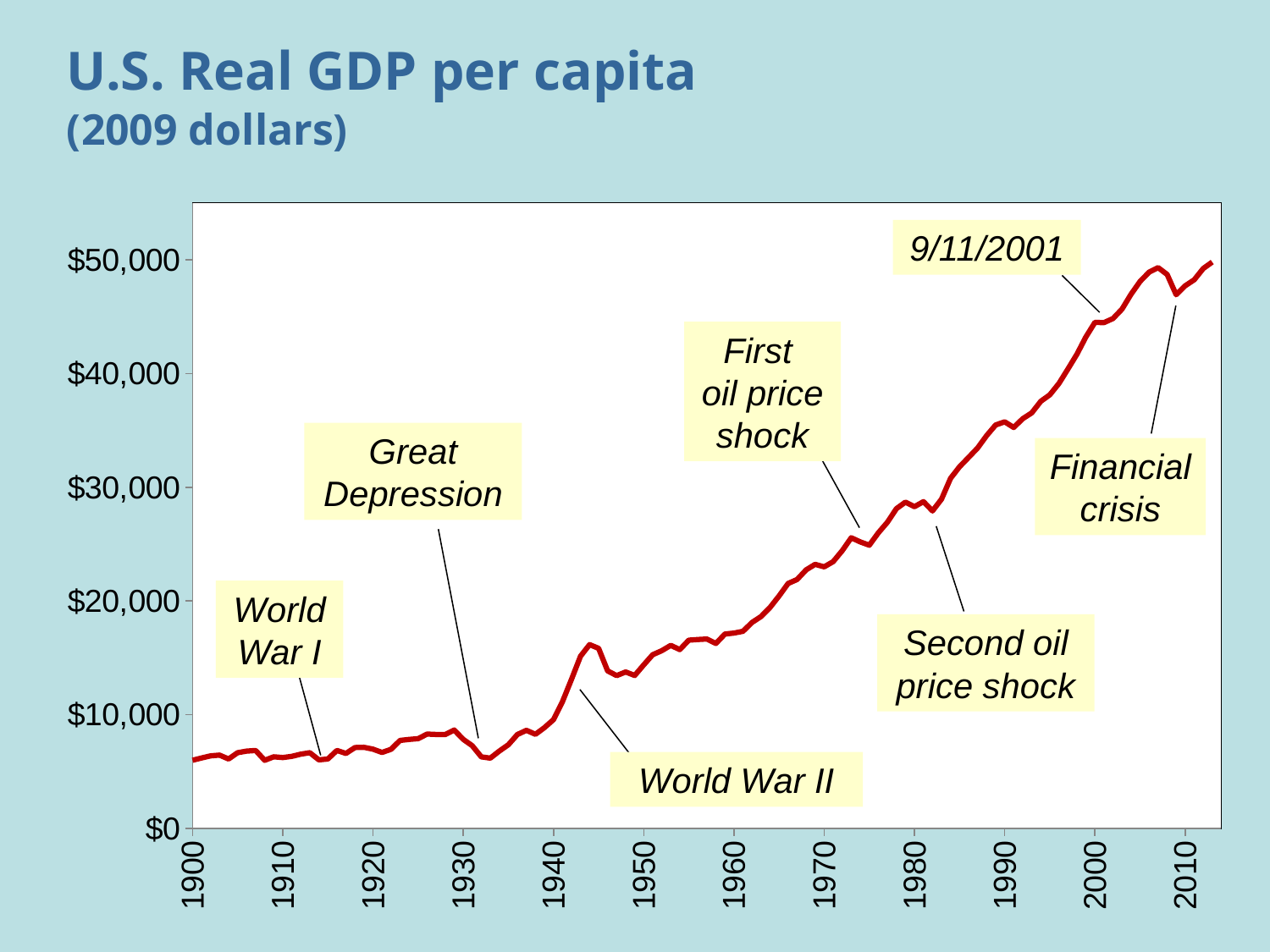
How many data series are plotted on the chart? 1 Is the value for 2010 greater or less than $40,000? greater Is the value for 1990 greater or less than $30,000? greater Is the value for 1900 greater or less than $10,000? less How many historical events are annotated on the chart? 7 What kind of chart is shown on the slide? line chart What is the title of the chart? U.S. Real GDP per capita (2009 dollars) Which year has the larger value, 1950 or 2000? 2000 Overall, does U.S. real GDP per capita rise or fall from 1900 to the end of the series? rise